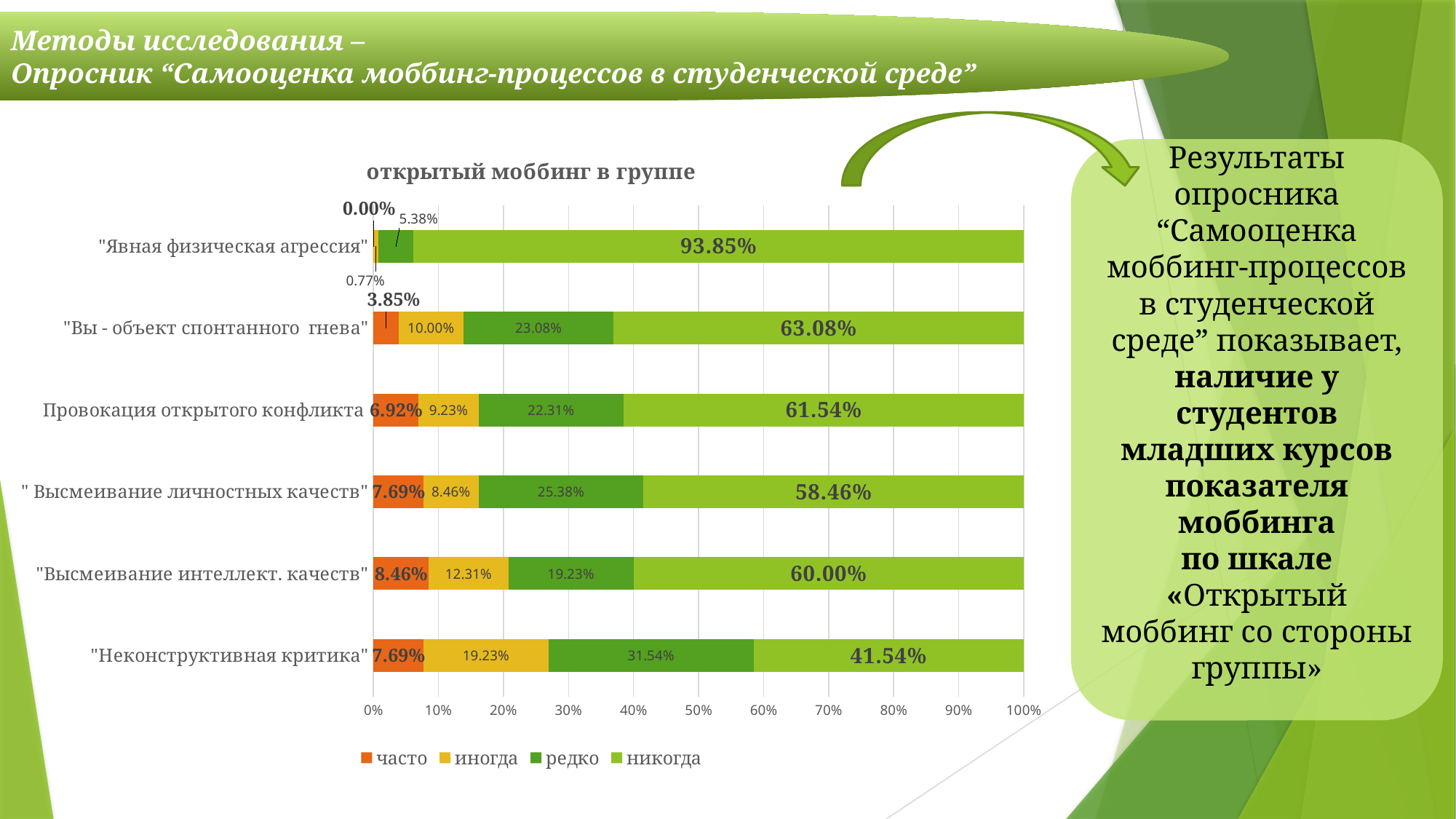
What is the value of "иногда" for "Высмеивание интеллект. качеств"? 12.31% Which category has the highest "никогда" value? "Явная физическая агрессия" What is the title of the chart? открытый моббинг в группе What is the value of "часто" for "Провокация открытого конфликта"? 6.92% How many categories are shown on the chart? 6 What is the value of "никогда" for "Явная физическая агрессия"? 93.85% What type of chart is shown on the slide? stacked bar chart Which is larger: the "редко" value for "Высмеивание личностных качеств" or for "Высмеивание интеллект. качеств"? "Высмеивание личностных качеств" Which category has the lowest "никогда" value? "Неконструктивная критика" What is the value of "редко" for "Неконструктивная критика"? 31.54% What is the difference between the "никогда" values for "Вы - объект спонтанного гнева" and "Неконструктивная критика"? 21.54% How many series does the chart legend list? 4